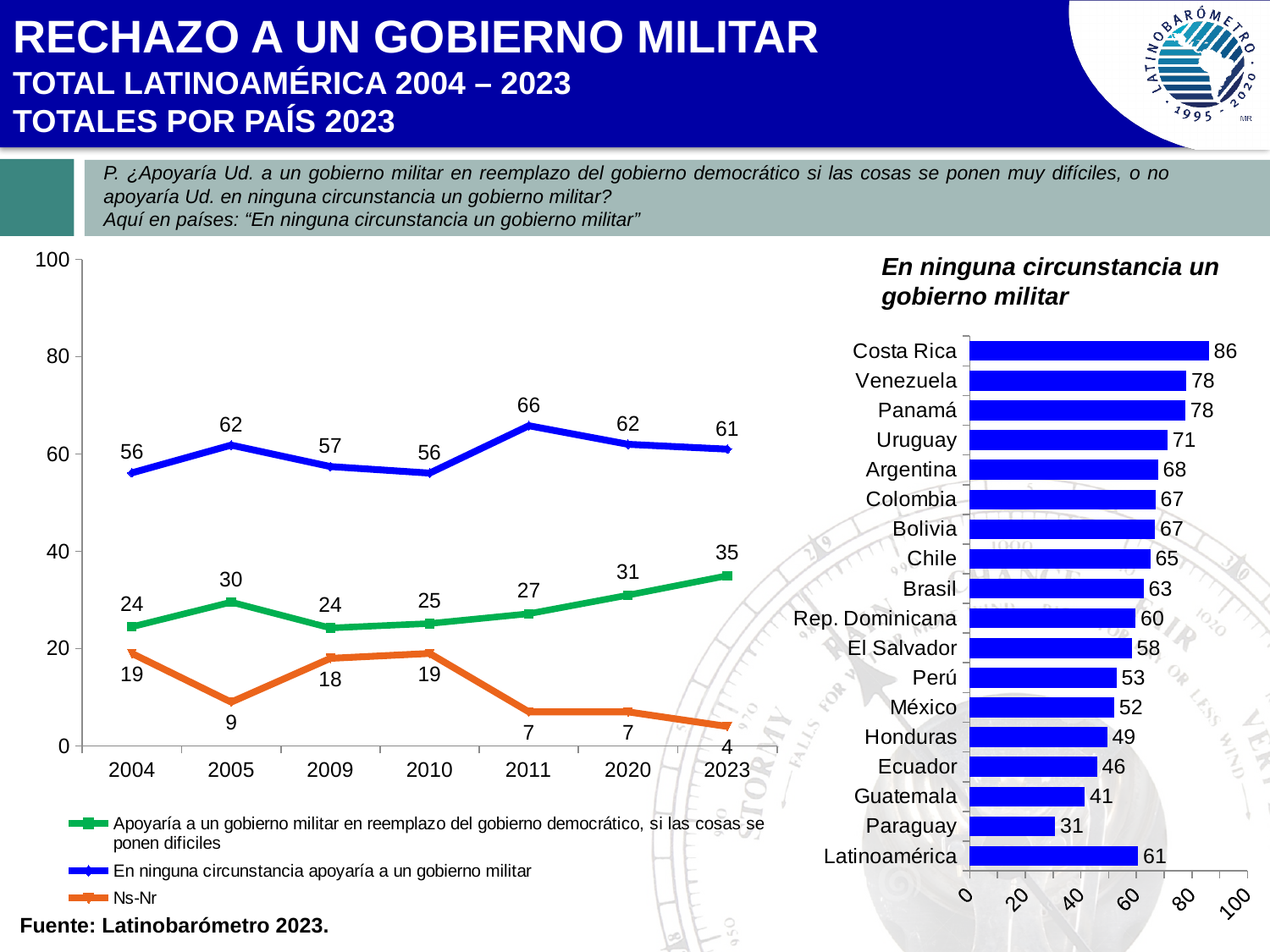
In the line chart on the left, how many series does the legend list? 3 In the bar chart 'En ninguna circunstancia un gobierno militar', which country has the lowest value? Paraguay In the bar chart 'En ninguna circunstancia un gobierno militar', what is the value for Uruguay? 71 In the bar chart 'En ninguna circunstancia un gobierno militar', which country has the highest value? Costa Rica In the bar chart 'En ninguna circunstancia un gobierno militar', which is larger, the value for Perú or the value for Honduras? Perú In the line chart on the left, what is the difference between the 'En ninguna circunstancia' value and the 'Apoyaría a un gobierno militar' value in 2023? 26 In the line chart on the left, what is the value for 'Ns-Nr' in 2023? 4 In the line chart on the left, does the 'Ns-Nr' series rise or fall between 2010 and 2023? fall In the line chart on the left, what is the value for 'En ninguna circunstancia apoyaría a un gobierno militar' in 2011? 66 In the line chart on the left, in which year is the 'Apoyaría a un gobierno militar' series highest? 2023 What kind of chart is the one on the right of the slide? bar chart In the line chart on the left, how many years are shown on the x axis? 7